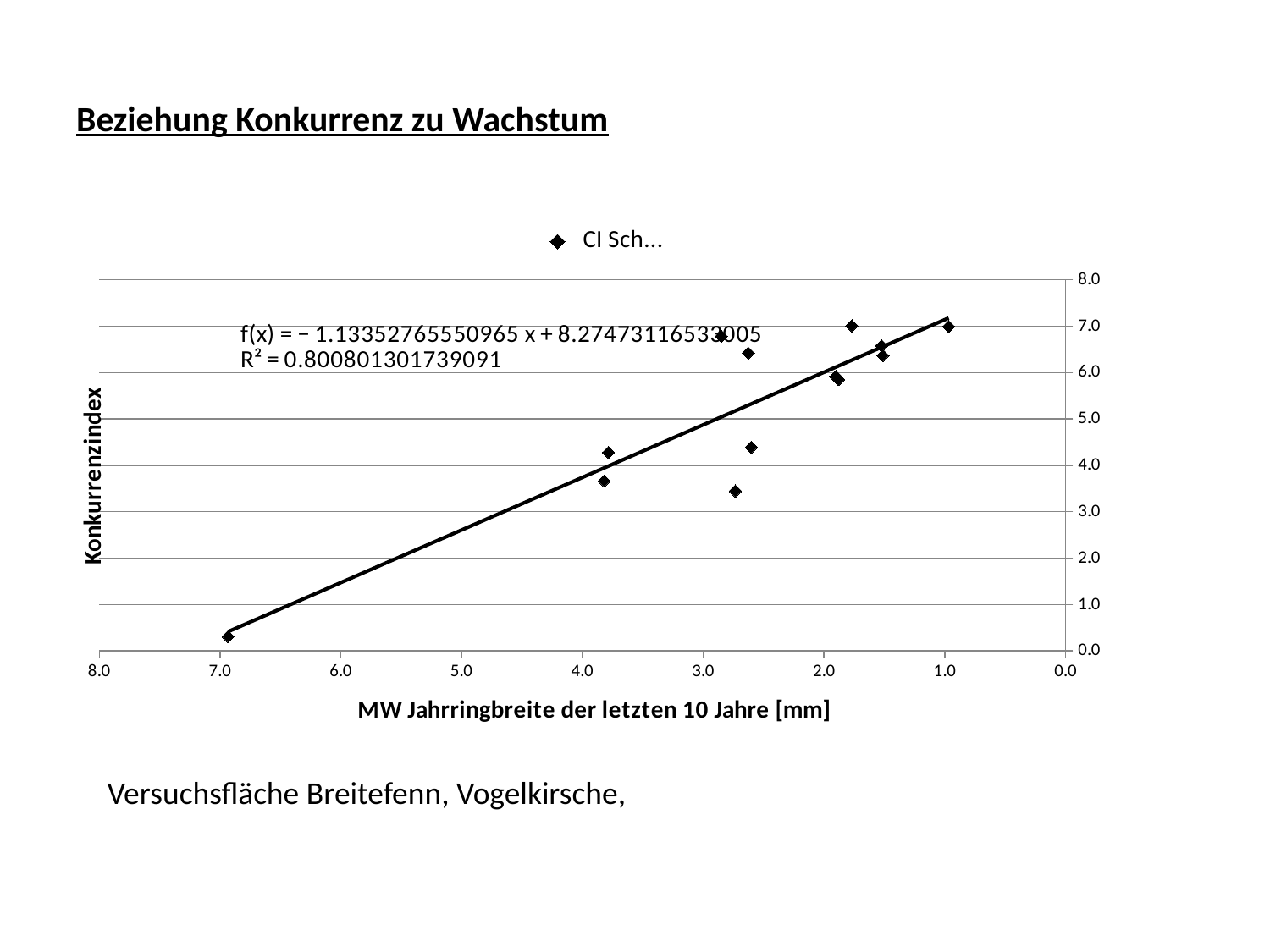
Which point has the lowest Konkurrenzindex: the one near 7.0 mm or the one near 3.8 mm? the one near 7.0 mm What kind of chart is shown on the slide? scatter chart Is the Konkurrenzindex of the point near 1.8 mm greater or less than 6.0? greater What is the slope of the trendline equation printed on the chart? −1.13352765550965 What is the maximum value shown on the y axis? 8.0 What is the title of the chart's x axis? MW Jahrringbreite der letzten 10 Jahre [mm] What R² value is printed on the chart for the trendline? 0.800801301739091 How many series does the chart's legend list? 1 What is the intercept of the trendline equation printed on the chart? 8.27473116533005 Is the Konkurrenzindex of the leftmost point (near 7.0 mm) greater or less than 1.0? less What is the title of the chart's y axis? Konkurrenzindex Do the plotted points generally rise or fall from left to right along the x axis? rise